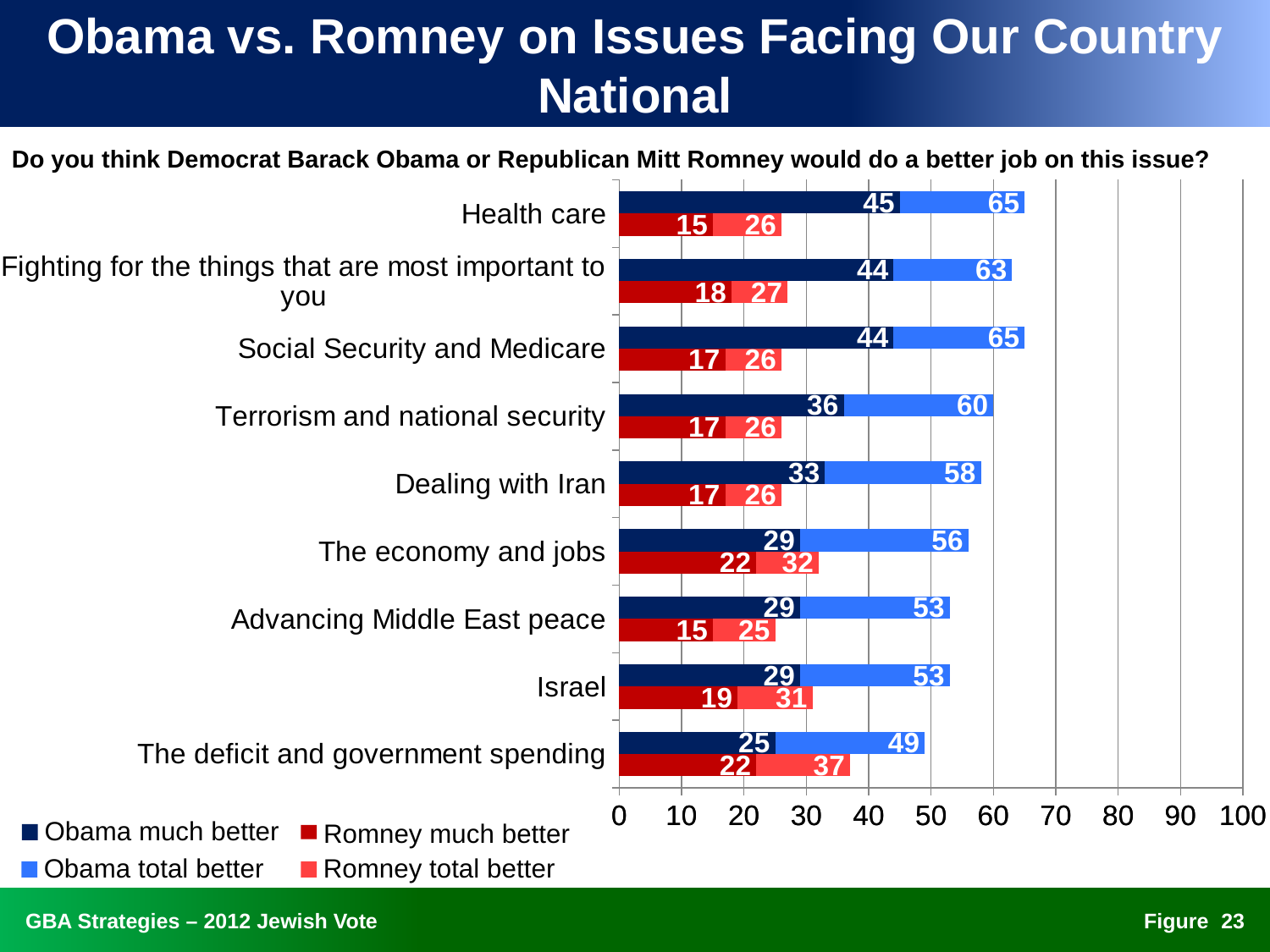
How many issues are listed on the chart? 9 Which issue has the lowest 'Obama total better' value? The deficit and government spending Which is larger on Dealing with Iran: 'Obama much better' or 'Romney total better'? Obama much better What is the maximum value shown on the horizontal axis? 100 Which issue has the highest 'Romney total better' value? The deficit and government spending How many series does the legend list? 4 What is the value for 'Obama total better' on Health care? 65 What is the value for 'Romney much better' on The economy and jobs? 22 What is the value for 'Obama much better' on Terrorism and national security? 36 What is the value for 'Romney total better' on The deficit and government spending? 37 What kind of chart is shown on the slide? Bar chart What is the difference between 'Obama total better' and 'Romney total better' on Israel? 22